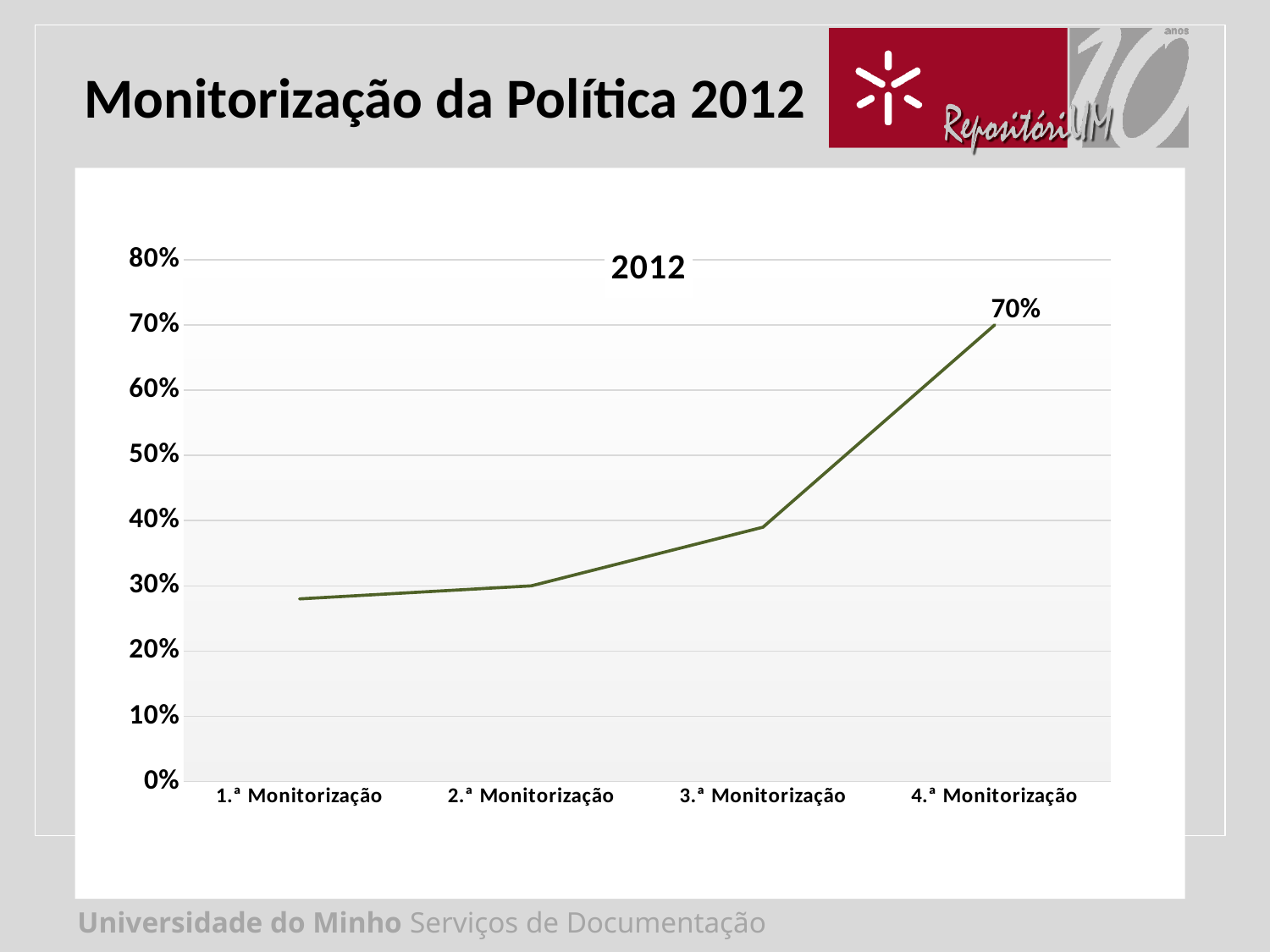
How many monitorização points are plotted on the x axis? 4 Do the values rise or fall from 1.ª Monitorização to 4.ª Monitorização? rise Is the value for 1.ª Monitorização greater or less than 20%? greater What type of chart is shown on the slide? line chart Which is larger, the value for 3.ª Monitorização or the value for 1.ª Monitorização? 3.ª Monitorização What is the value for 4.ª Monitorização? 70% Is the value for 3.ª Monitorização greater or less than 50%? less What is the title of the chart? 2012 Which is larger, the value for 4.ª Monitorização or the value for 1.ª Monitorização? 4.ª Monitorização Is the value for 3.ª Monitorização greater or less than 30%? greater Which monitorização has the highest value? 4.ª Monitorização